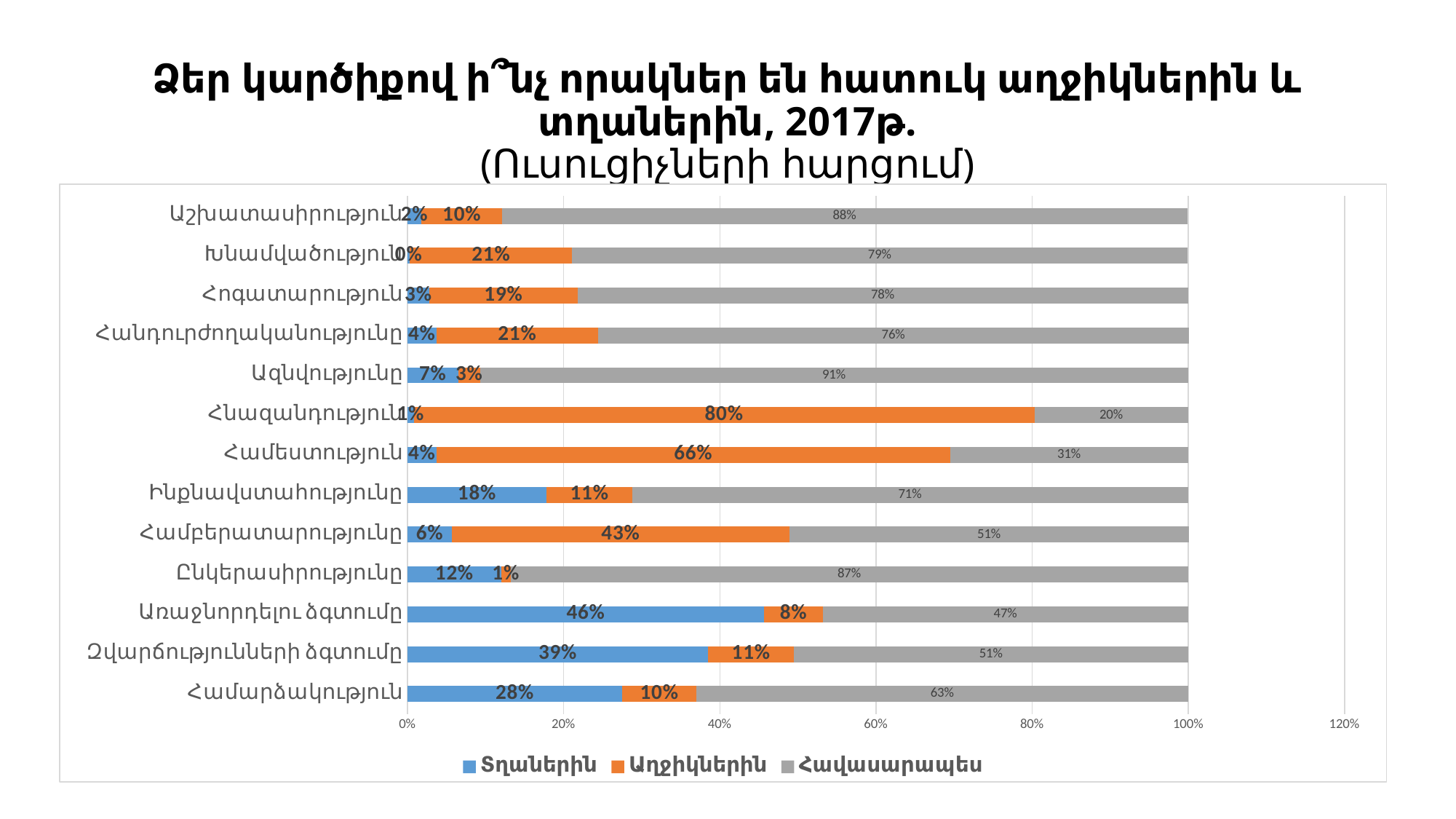
What kind of chart is shown on the slide? Stacked bar chart Which is larger: the Տղաներին value for Զվարճությունների ձգտումը or for Համարձակություն? Զվարճությունների ձգտումը What is the difference between the Աղջիկներին values for Հնազանդություն and Համեստություն? 14% What is the Աղջիկներին value for Համբերատարությունը? 43% How many categories are plotted on the chart? 13 Which category has the highest Տղաներին value? Առաջնորդելու ձգտումը What is the Հավասարապես value for Աշխատասիրություն? 88% How many series does the legend list? 3 Which category has the lowest Հավասարապես value? Հնազանդություն Which category has the highest Աղջիկներին value? Հնազանդություն What is the Աղջիկներին value for Հնազանդություն? 80% What is the Տղաներին value for Առաջնորդելու ձգտումը? 46%